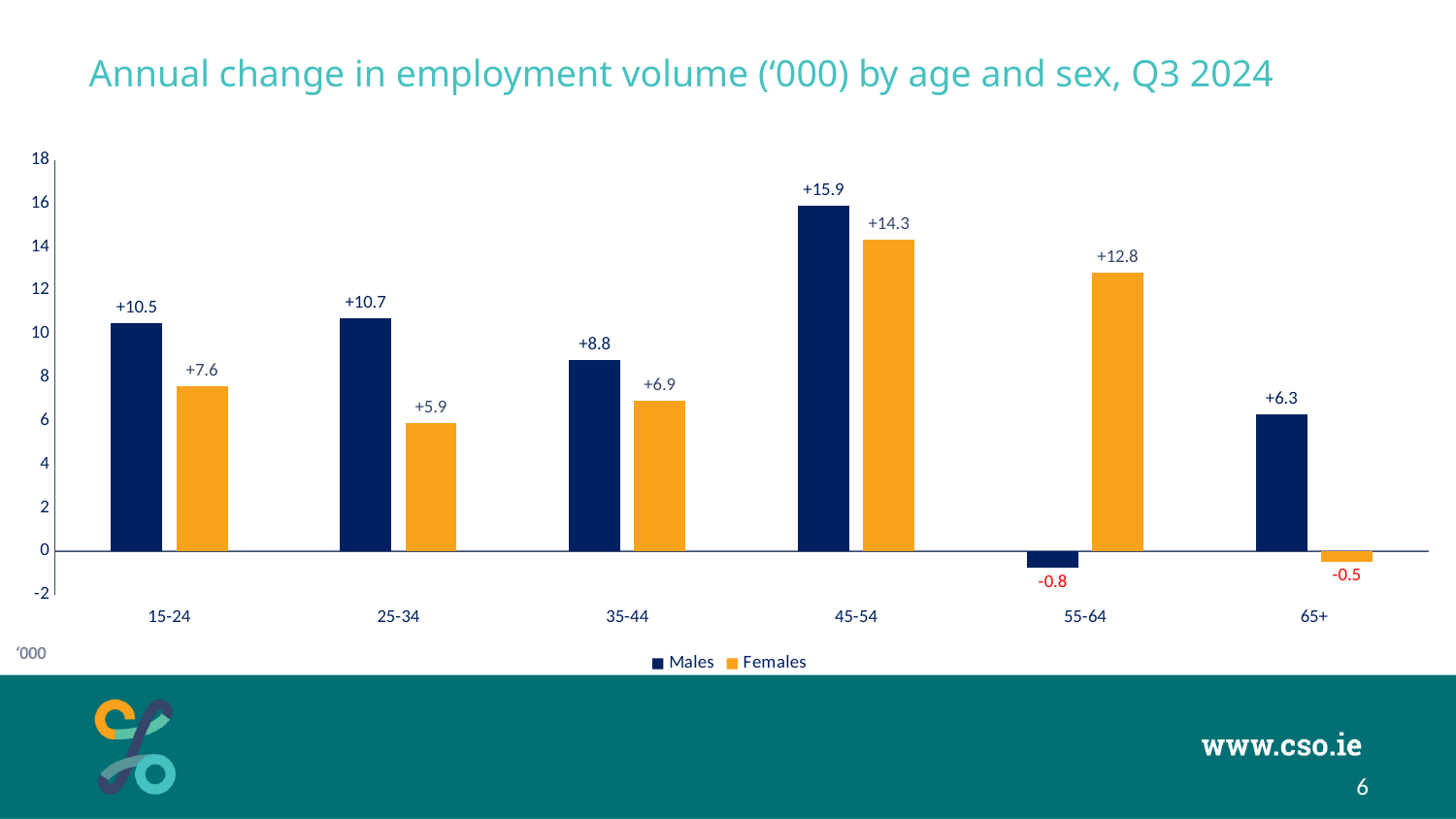
Which age group has the highest value for Males? 45-54 What is the value for Females in the 65+ age group? -0.5 Which age group has the lowest value for Females? 65+ How many age groups are shown on the x axis? 6 What is the title of the chart? Annual change in employment volume ('000) by age and sex, Q3 2024 What is the value for Females in the 55-64 age group? +12.8 In the 55-64 age group, which is larger, the value for Males or for Females? Females What kind of chart is shown on the slide? Bar chart What is the value for Males in the 45-54 age group? +15.9 How many series does the legend list? 2 What is the value for Males in the 55-64 age group? -0.8 What is the difference between the Males and Females values in the 25-34 age group? 4.8